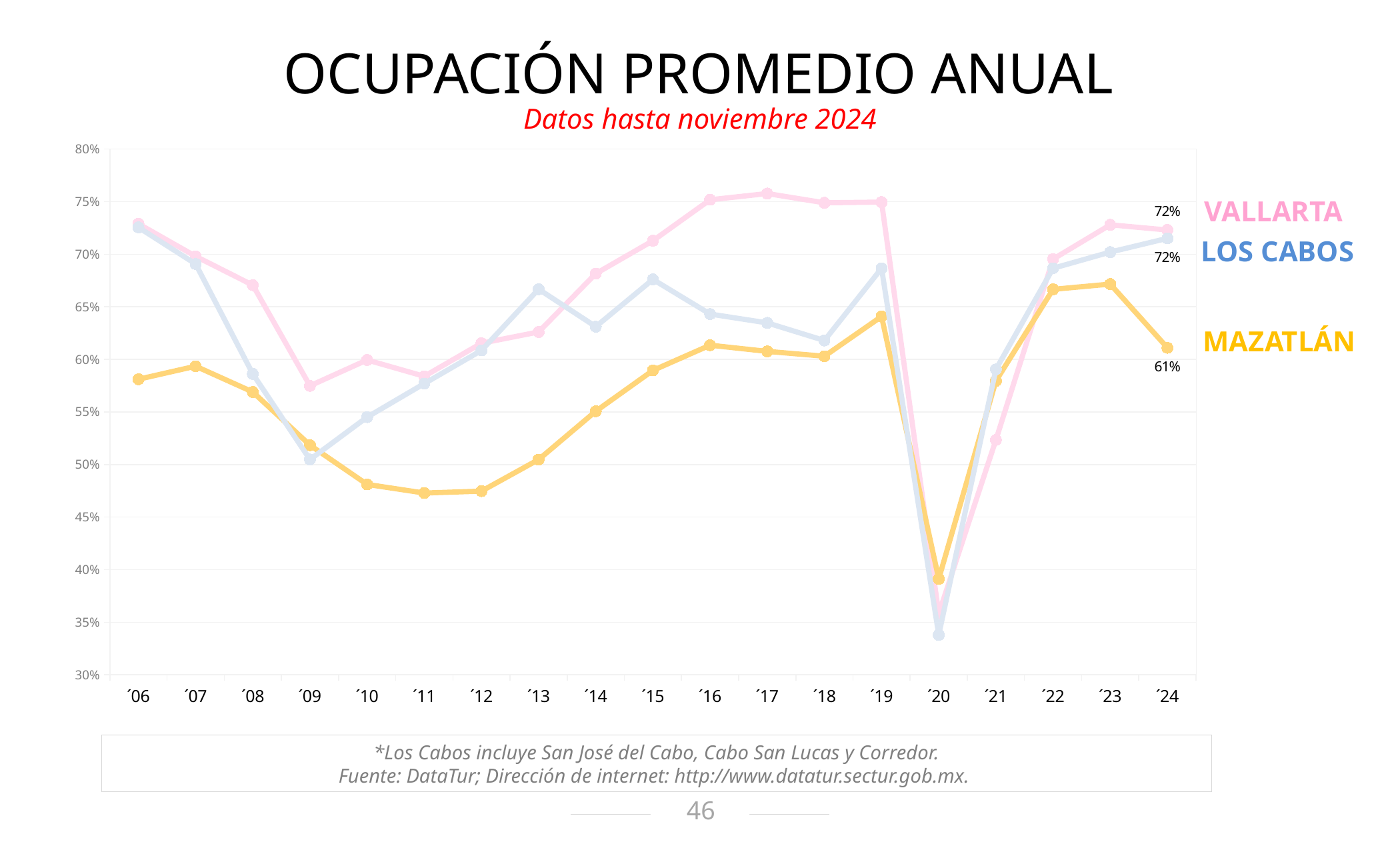
How many years are shown along the x axis? 19 What kind of chart is shown on the slide? Line chart Is the value for Mazatlán in '11 greater or less than 50%? less What is the value for Vallarta in '24? 72% Which is larger in '13, the Los Cabos value or the Vallarta value? Los Cabos Is the value for Los Cabos in '20 greater or less than 40%? less What is the difference between the Vallarta and Mazatlán values in '24? 11 percentage points How many series are plotted on the chart? 3 Does the Mazatlán value rise or fall from '23 to '24? Fall What is the value for Los Cabos in '24? 72% In which year is the Vallarta value lowest? '20 What is the value for Mazatlán in '24? 61%